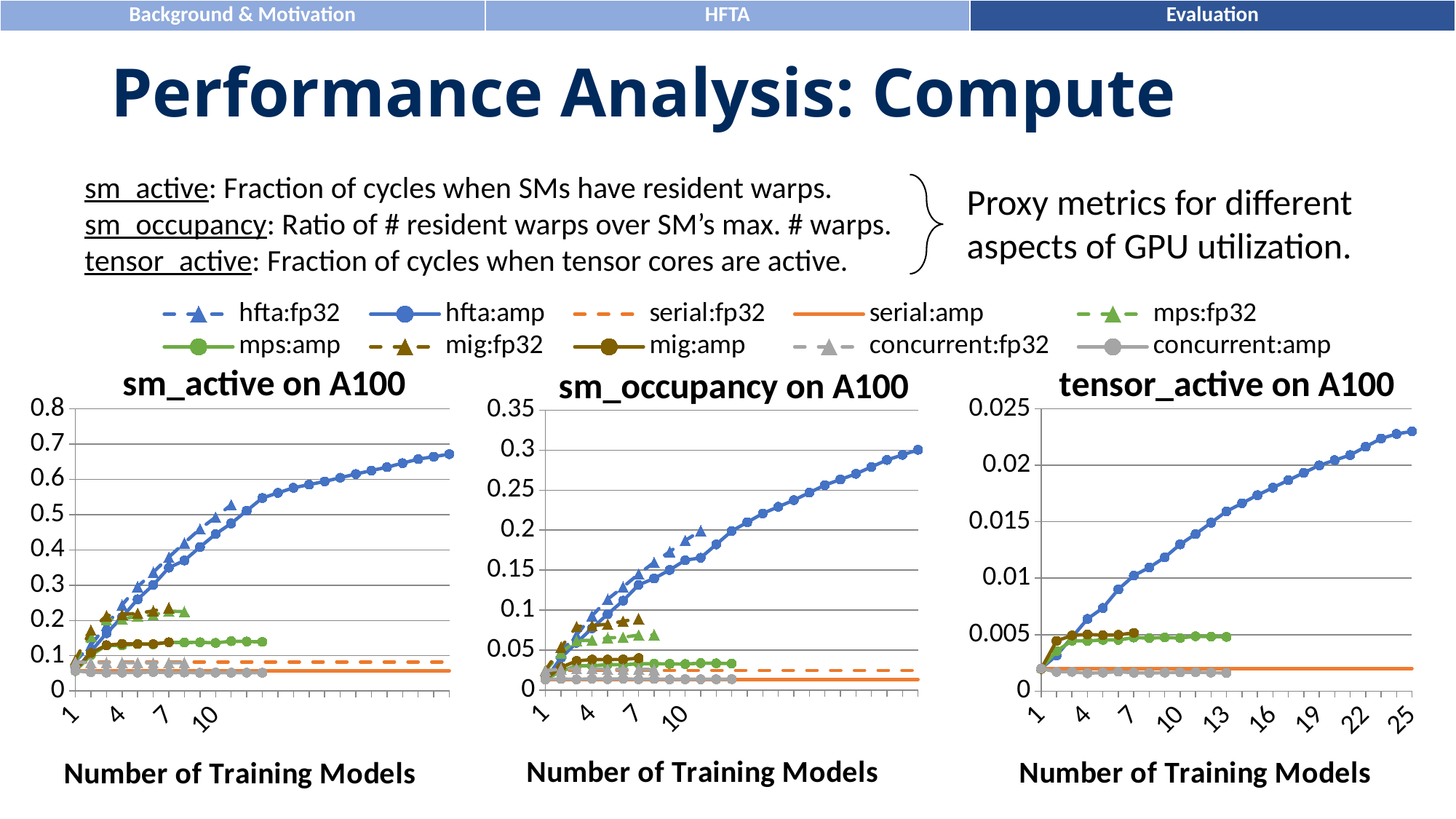
In the 'sm_occupancy on A100' chart, which is higher, mig:fp32 or mig:amp? mig:fp32 In the 'sm_occupancy on A100' chart, is the hfta:amp value at 25 training models greater or less than 0.25? greater In the 'tensor_active on A100' chart, does the hfta:amp series rise or fall as the number of training models increases? rise In the 'sm_active on A100' chart, which is higher, serial:fp32 or serial:amp? serial:fp32 What kind of chart is 'sm_active on A100'? line chart What is the x-axis label of the 'sm_occupancy on A100' chart? Number of Training Models In the 'tensor_active on A100' chart, is the hfta:amp value at 25 training models greater or less than 0.02? greater In the 'tensor_active on A100' chart, is the hfta:amp value at 1 training model greater or less than 0.005? less How many charts are shown on the slide? 3 How many series does the shared legend list? 10 In the 'sm_active on A100' chart, which series reaches the highest value? hfta:amp